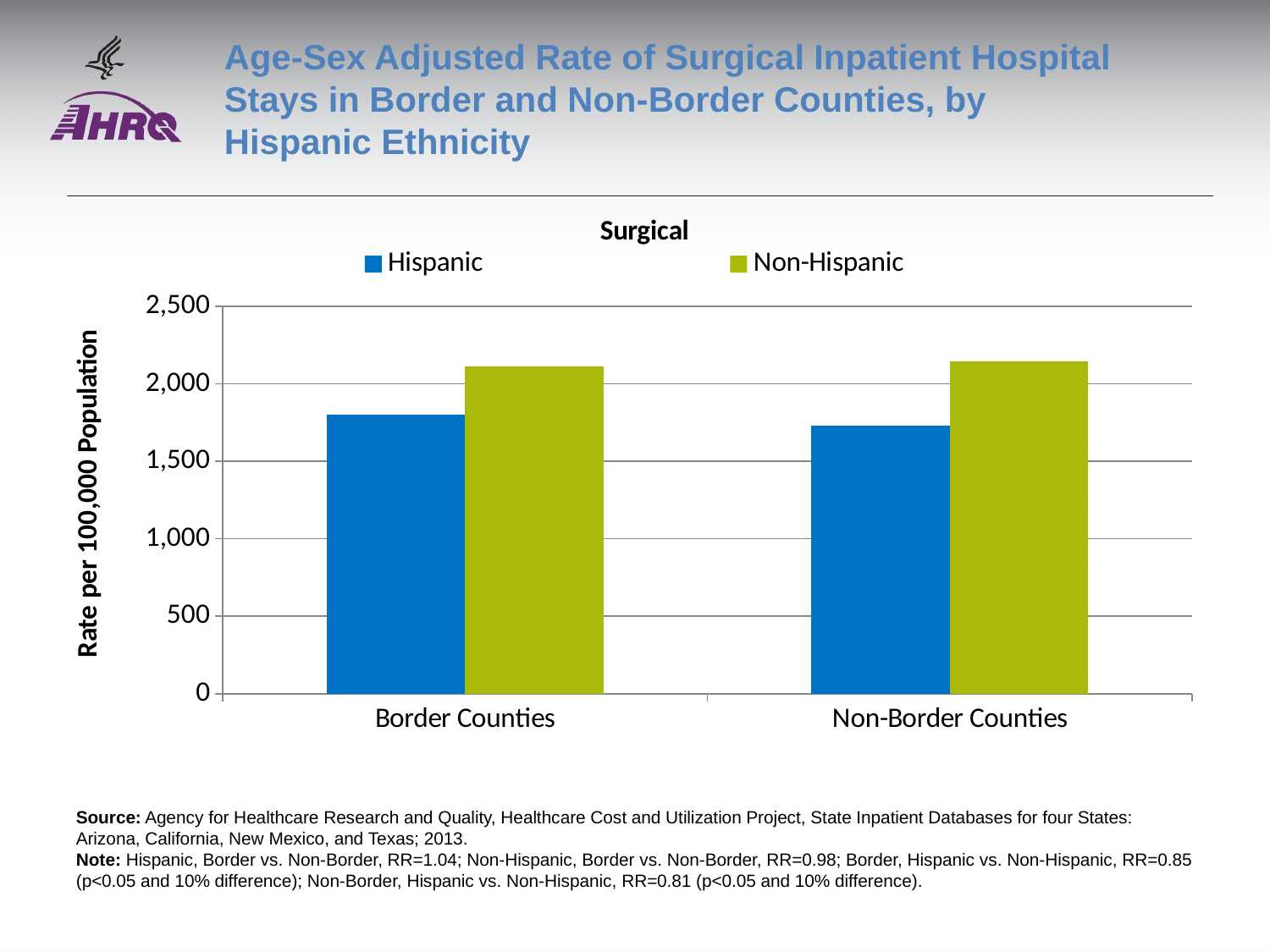
Is the Non-Hispanic value for Non-Border Counties greater or less than 2,000? greater Is the Hispanic value for Non-Border Counties greater or less than 1,500? greater How many categories are shown on the x axis? 2 What type of chart is shown on the slide? bar chart Is the Hispanic value for Non-Border Counties greater or less than 2,000? less In Non-Border Counties, which series has the lower rate, Hispanic or Non-Hispanic? Hispanic In Border Counties, which series has the higher rate, Hispanic or Non-Hispanic? Non-Hispanic What is the label of the y axis? Rate per 100,000 Population How many series does the legend list? 2 What is the title of the chart? Surgical